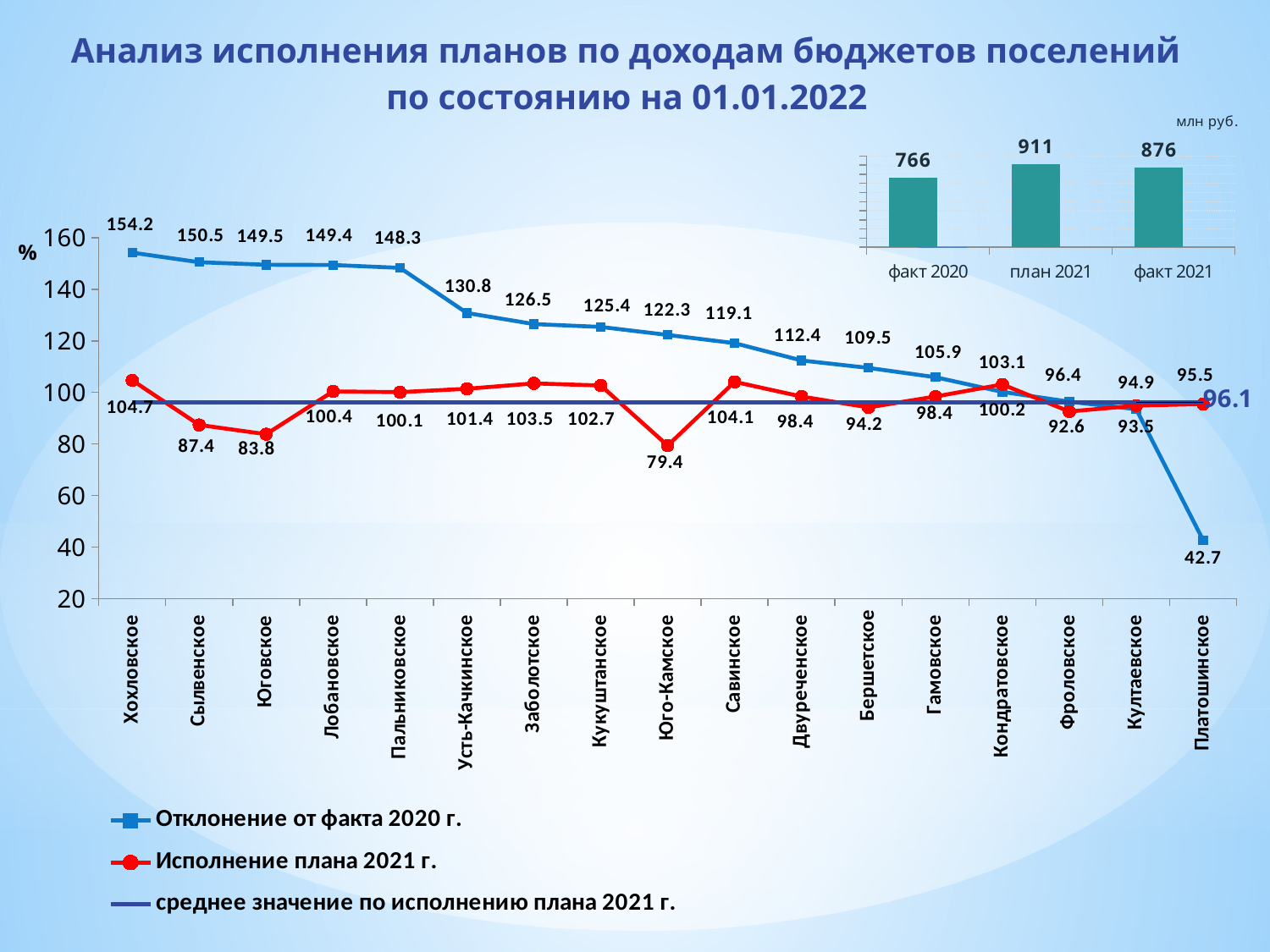
In the large line chart, what is the value of 'Отклонение от факта 2020 г.' for Хохловское? 154.2 In the large line chart, what is the difference between the 'Отклонение от факта 2020 г.' values for Хохловское and Сылвенское? 3.7 In the large line chart, what is the value of the line 'среднее значение по исполнению плана 2021 г.'? 96.1 What kind of chart is the large chart on the left of the slide? line chart In the large line chart, how many settlements are shown on the x axis? 17 In the large line chart, what is the value of 'Исполнение плана 2021 г.' for Юго-Камское? 79.4 In the large line chart, which settlement has the lowest value for 'Отклонение от факта 2020 г.'? Платошинское In the small bar chart in the top right, which category has the highest value? план 2021 In the large line chart, which has the larger 'Исполнение плана 2021 г.' value, Сылвенское or Юговское? Сылвенское In the large line chart, how many series does the legend list? 3 In the small bar chart in the top right, what is the difference between 'план 2021' and 'факт 2021'? 35 In the large line chart, which settlement has the lowest value for 'Исполнение плана 2021 г.'? Юго-Камское